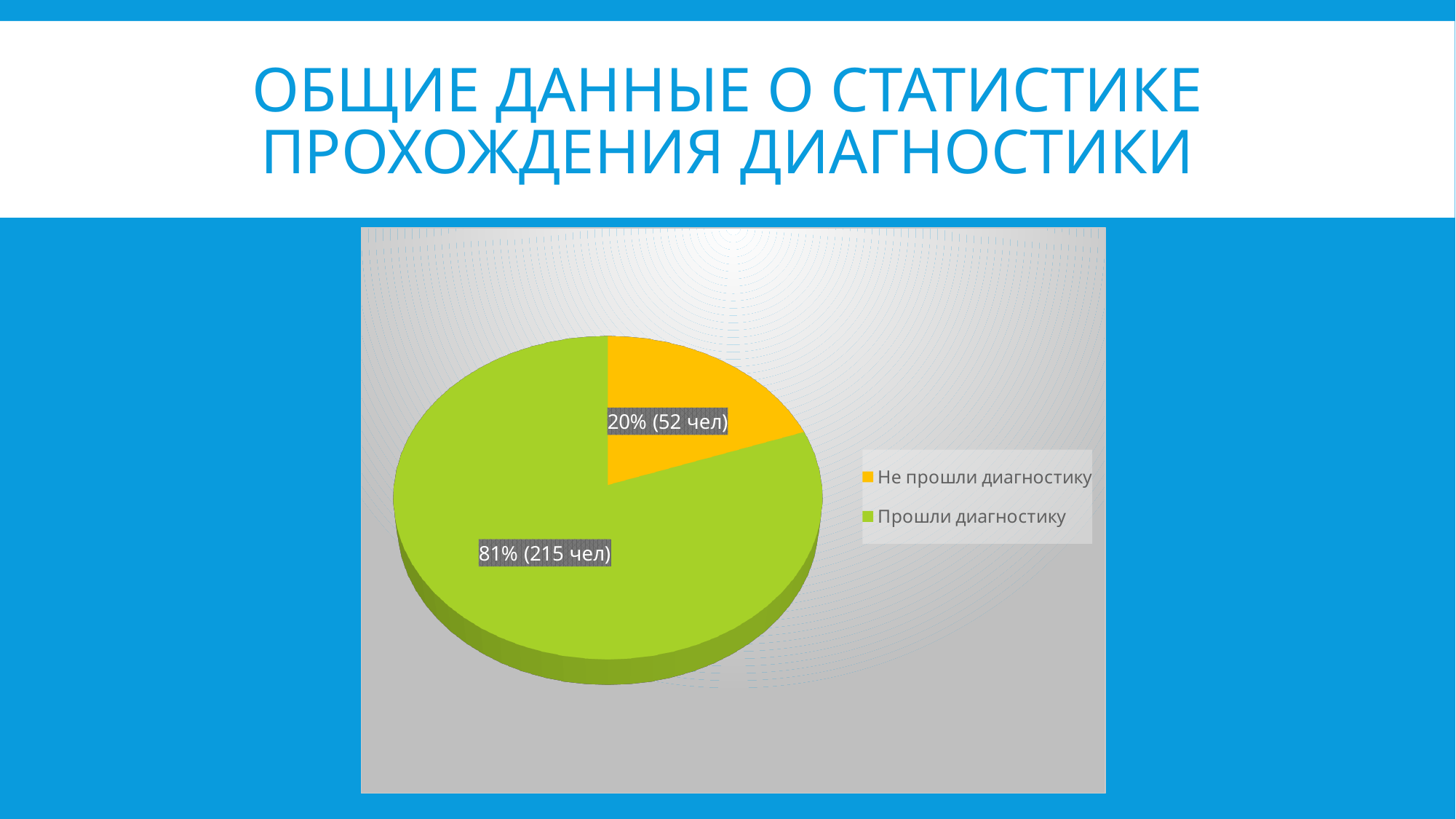
Which is larger: the number of people who passed the diagnostics ("Прошли диагностику") or those who did not ("Не прошли диагностику")? Прошли диагностику Which category has the smallest slice of the pie? Не прошли диагностику What is the data label shown on the slice for "Не прошли диагностику"? 20% (52 чел) How many entries does the legend list? 2 What share of the pie does "Не прошли диагностику" represent? 20% What kind of chart is shown on the slide? Pie chart Which category has the largest slice of the pie? Прошли диагностику How many more people are in "Прошли диагностику" than in "Не прошли диагностику"? 163 чел What share of the pie does "Прошли диагностику" represent? 81% What colour is the slice for "Не прошли диагностику"? Orange How many slices does the pie chart have? 2 What is the data label shown on the slice for "Прошли диагностику"? 81% (215 чел)